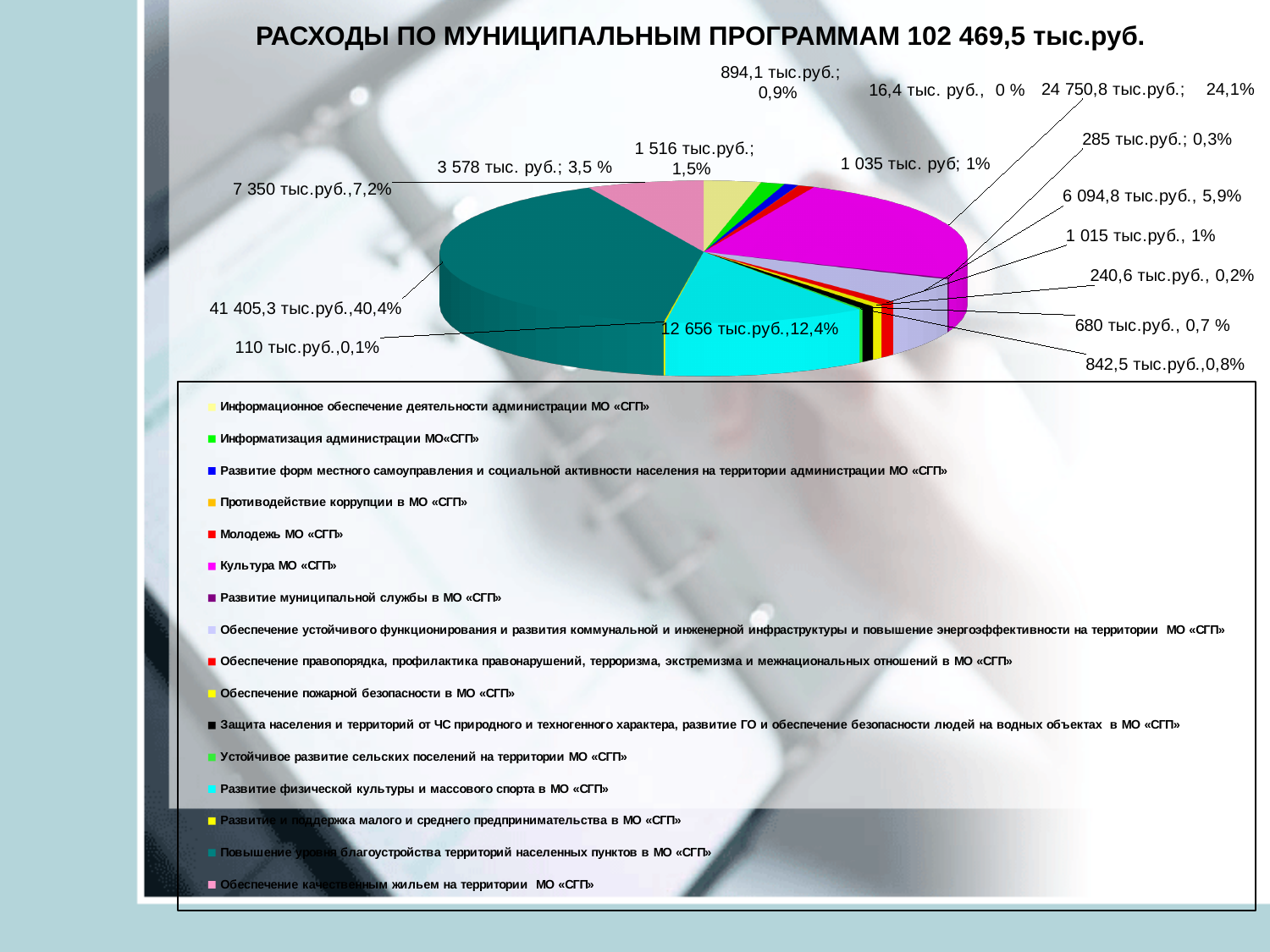
Which programme does the largest slice (40,4%) correspond to? Повышение уровня благоустройства территорий населенных пунктов в МО «СГП» What share is labelled for the slice with value 6 094,8 тыс.руб.? 5,9% What is the value of the cyan slice for «Развитие физической культуры и массового спорта в МО «СГП»»? 12 656 тыс.руб. What is the share of the pink slice for «Обеспечение качественным жильем на территории МО «СГП»»? 7,2% What total amount of expenditure on municipal programmes is stated in the chart title? 102 469,5 тыс.руб. What type of chart is shown on the slide? pie chart Which is larger: the slice for «Культура МО «СГП»» or the slice for «Развитие физической культуры и массового спорта»? Культура МО «СГП» How many programmes are listed in the chart legend? 16 What is the value and share of the largest slice of the pie? 41 405,3 тыс.руб., 40,4% What is the difference between the largest slice (41 405,3 тыс.руб.) and the «Культура» slice (24 750,8 тыс.руб.)? 16 654,5 тыс.руб. What is the value of the smallest slice of the pie? 16,4 тыс. руб. What share of expenditure goes to the programme «Культура МО «СГП»» (magenta slice)? 24,1%